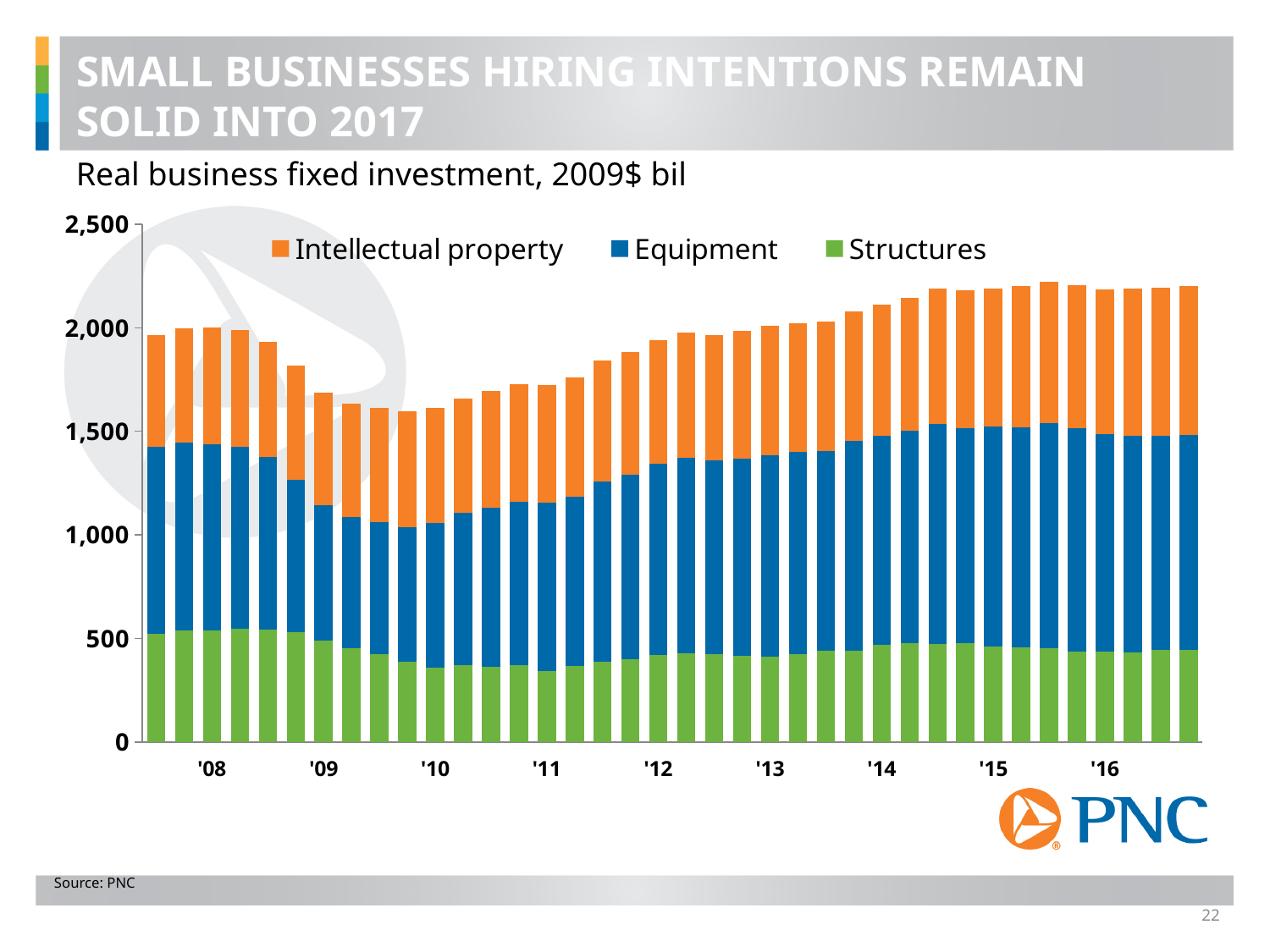
Is the total real business fixed investment in 2016 greater or less than 2,000? greater Is the total real business fixed investment in 2009 greater or less than 2,000? less Is the Structures value in 2010 greater or less than 500? less How many year labels are shown on the x axis? 9 Which is larger in 2016, the Equipment segment or the Structures segment? Equipment What kind of chart is shown on the slide? Stacked bar chart What are the three series listed in the legend? Intellectual property, Equipment, Structures Does total real business fixed investment rise or fall from 2010 to 2016? rise How many series does the legend list? 3 What is the subtitle describing the data plotted in the chart? Real business fixed investment, 2009$ bil Does total real business fixed investment rise or fall from 2008 to 2010? fall